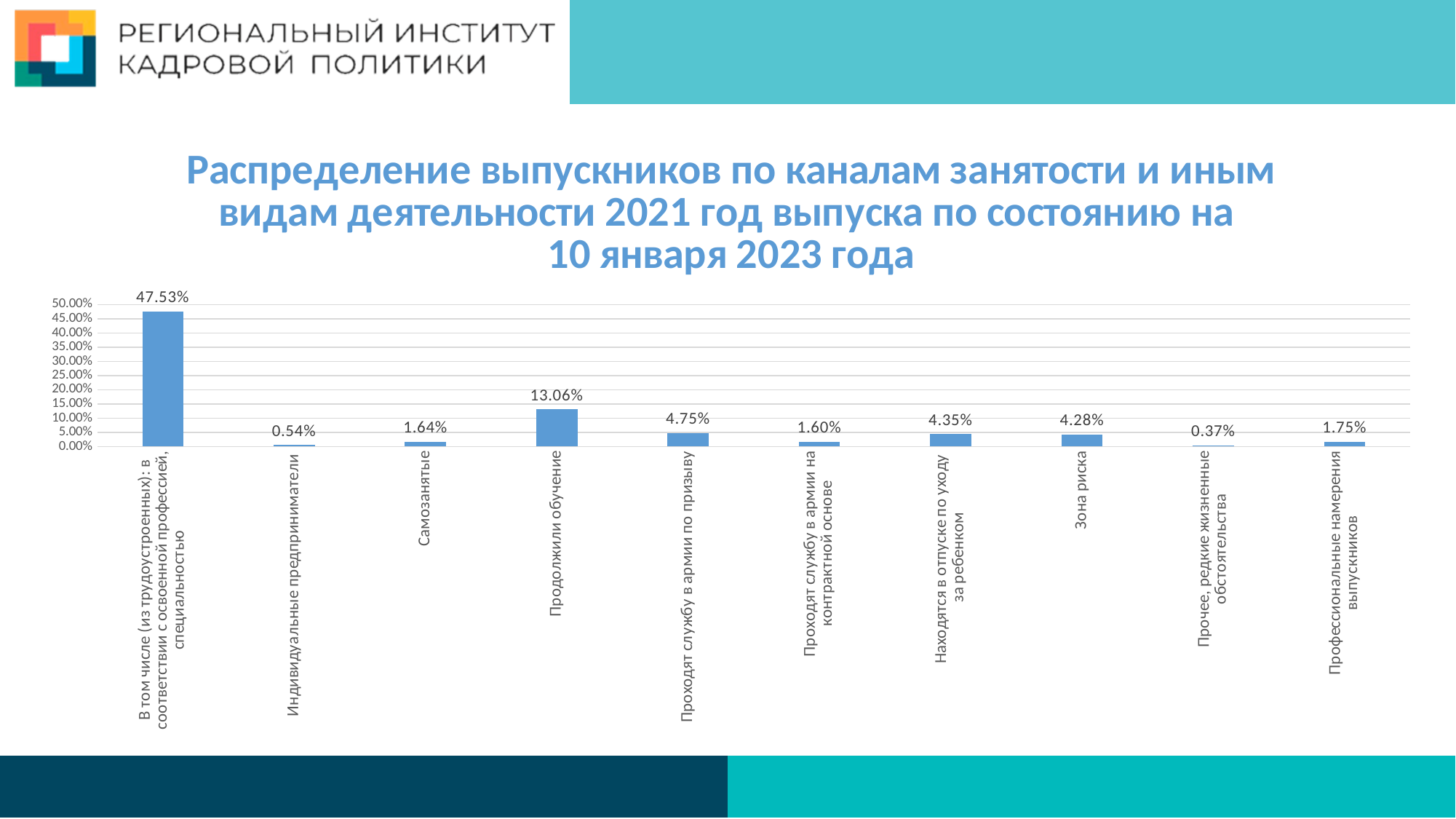
Which is larger: the value for «Находятся в отпуске по уходу за ребенком» or for «Зона риска»? Находятся в отпуске по уходу за ребенком What value is shown for «Индивидуальные предприниматели»? 0.54% What value is shown for «Самозанятые»? 1.64% What is the difference between the values for «Проходят службу в армии по призыву» and «Проходят службу в армии на контрактной основе»? 3.15% What kind of chart is shown on the slide? Bar chart Which category has the highest value? В том числе (из трудоустроенных): в соответствии с освоенной профессией, специальностью What value is shown for «Продолжили обучение»? 13.06% Which category has the lowest value? Прочее, редкие жизненные обстоятельства How many categories are shown on the x axis? 10 What is the highest tick value shown on the vertical axis? 50.00% Is the value for «Продолжили обучение» greater or less than 10.00%? greater What value is shown for «Зона риска»? 4.28%